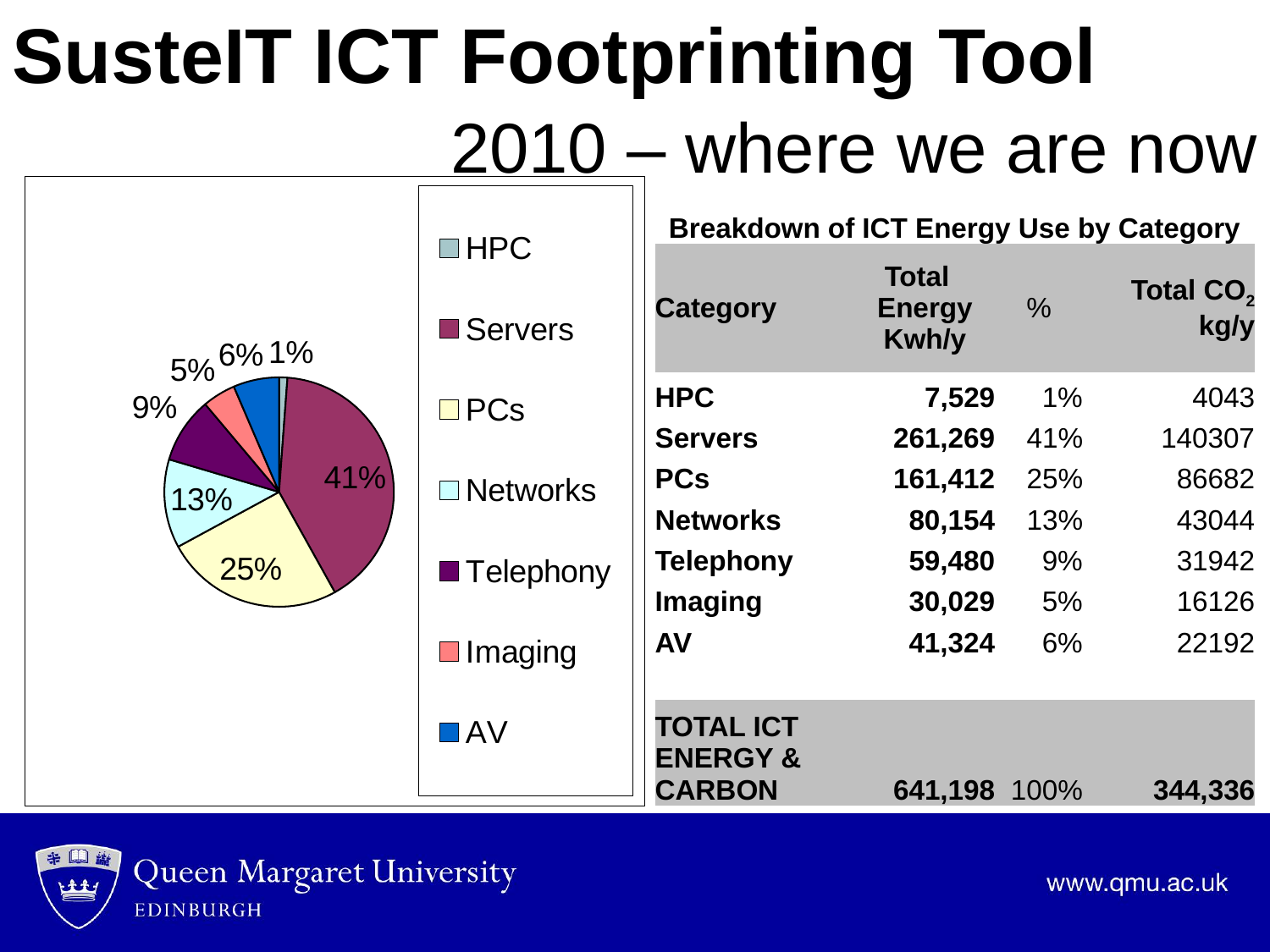
Which category has the largest slice of the pie? Servers What share of the pie does Telephony account for? 9% What share of the pie does HPC account for? 1% How many categories does the pie chart legend list? 7 What share of the pie does PCs account for? 25% What is the difference in percentage points between the Servers slice and the PCs slice? 16% What kind of chart is shown on the slide? Pie chart What colour is the Servers slice in the pie chart? Dark magenta Which category has the smallest slice of the pie? HPC Which slice is larger, Imaging or AV? AV